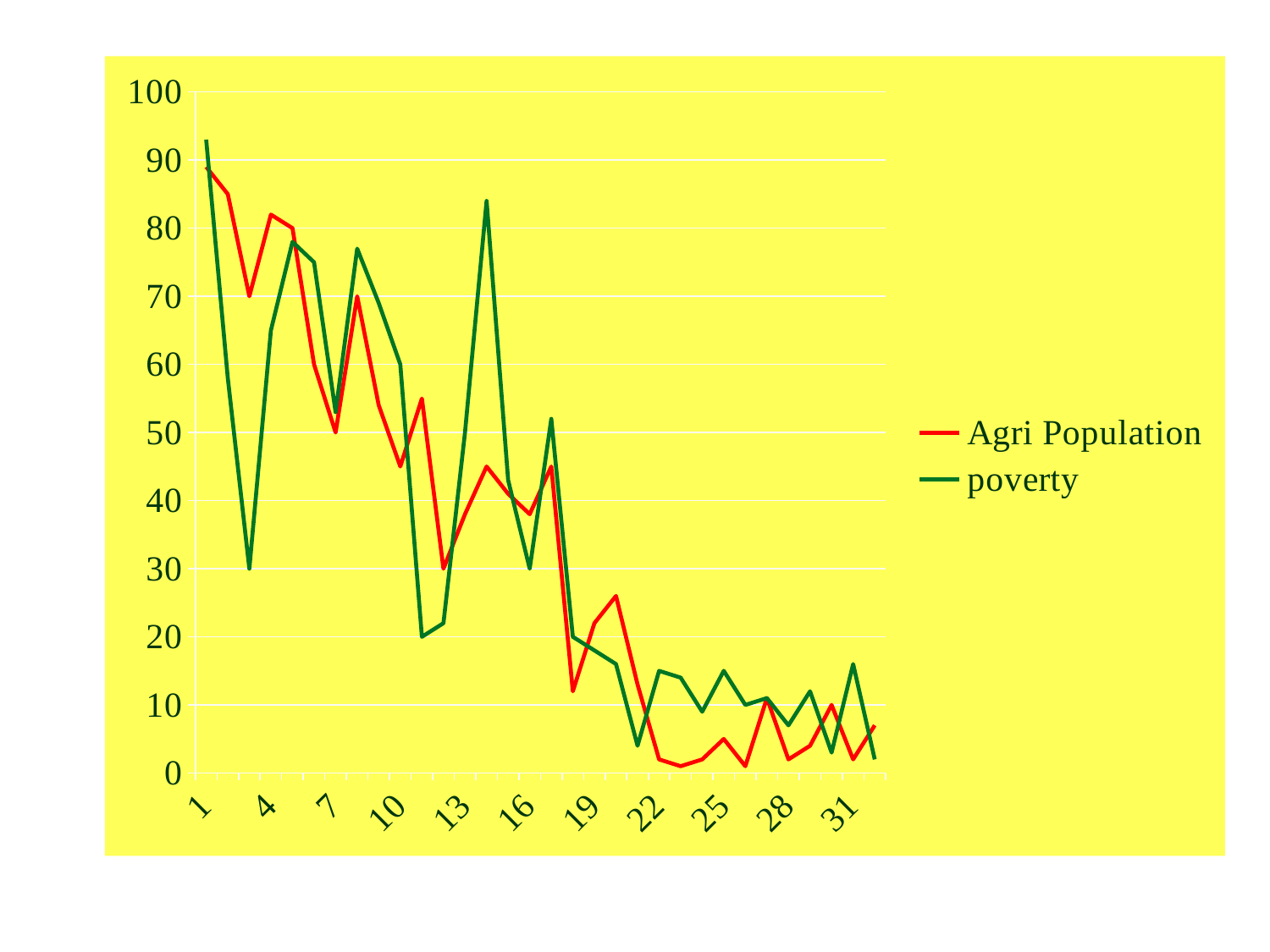
Is the value for poverty at point 1 greater or less than 90? greater Do the values of the Agri Population series generally rise or fall along the x axis? fall Which series reaches the highest value anywhere on the chart? poverty Is the value for Agri Population at point 12 greater or less than 50? less At point 3, which series has the larger value, Agri Population or poverty? Agri Population Which colour is used for the poverty line? green What kind of chart is shown on the slide? line chart At point 14, which series has the larger value, Agri Population or poverty? poverty How many series does the legend list? 2 Is the value for poverty at point 14 greater or less than 80? greater What are the names of the two series in the legend? Agri Population and poverty